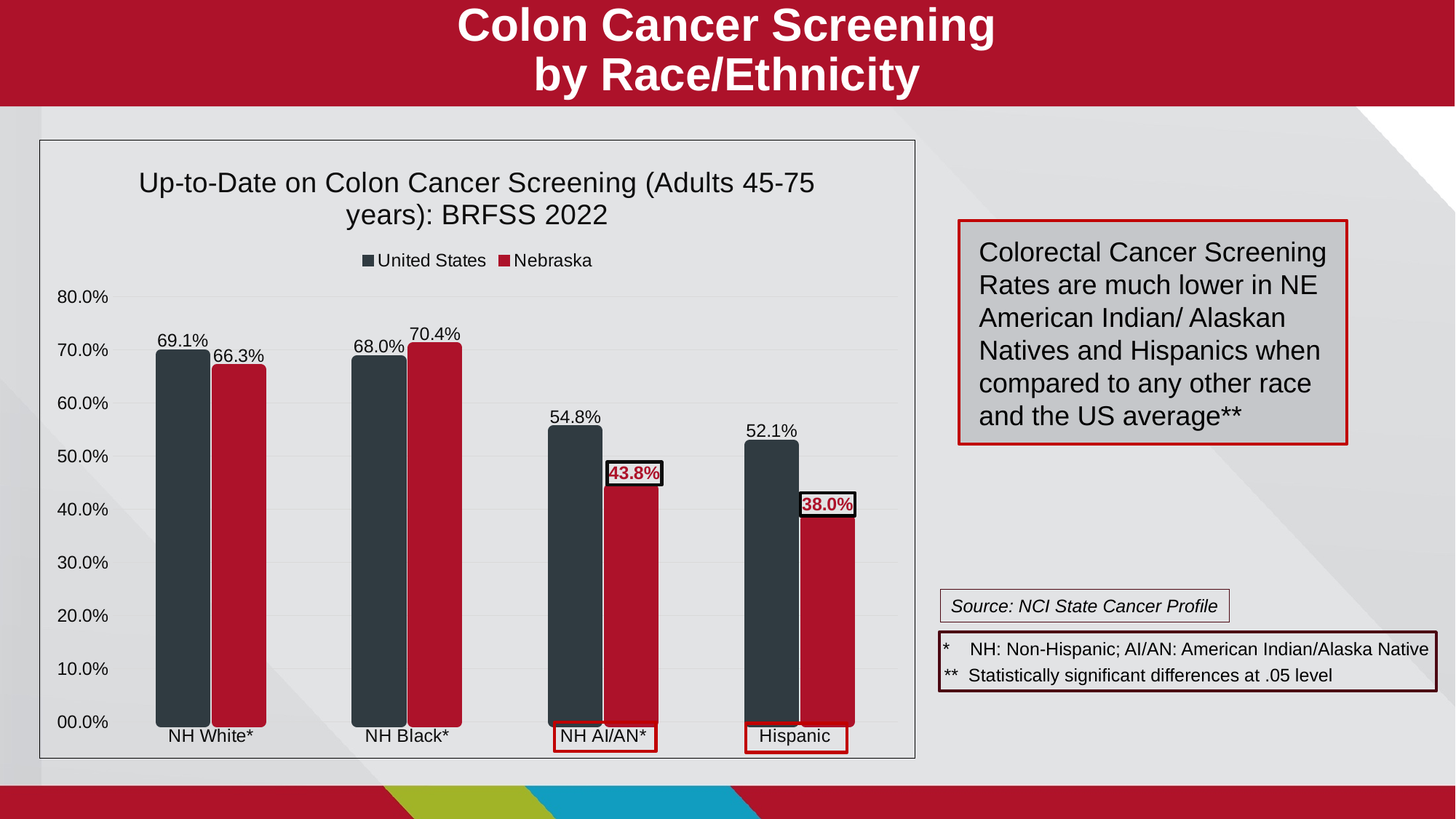
How many series does the legend list? 2 What is the Nebraska value for NH AI/AN*? 43.8% Which category has the highest Nebraska value? NH Black* What is the Nebraska value for Hispanic? 38.0% What kind of chart is shown? bar chart How many race/ethnicity categories are shown on the x axis? 4 What colour are the Nebraska bars? red Which category has the lowest United States value? Hispanic What is the United States value for NH Black*? 68.0% Is the Nebraska value for NH AI/AN* greater or less than 50.0%? less Which is larger for NH White*, the United States value or the Nebraska value? United States What is the difference between the United States and Nebraska values for Hispanic? 14.1%